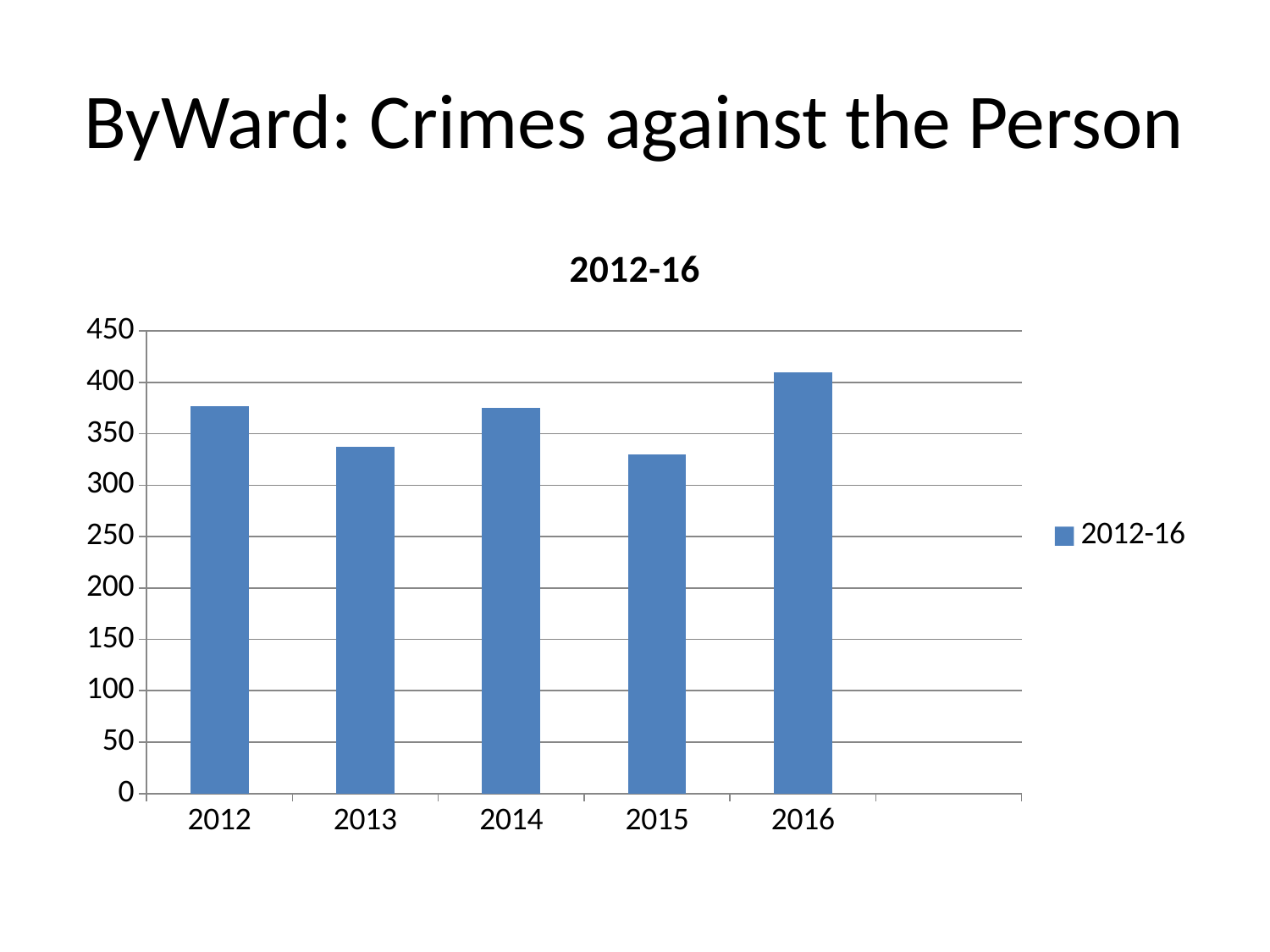
Which year has the highest value? 2016 Is the value for 2015 greater or less than 350? less How many years are plotted on the chart? 5 Which is larger, the value for 2016 or the value for 2013? 2016 What is the title of the chart? 2012-16 Is the value for 2012 greater or less than 350? greater Is the value for 2014 greater or less than 350? greater Which is larger, the value for 2015 or the value for 2012? 2012 What kind of chart is shown on the slide? bar chart How many series does the legend list? 1